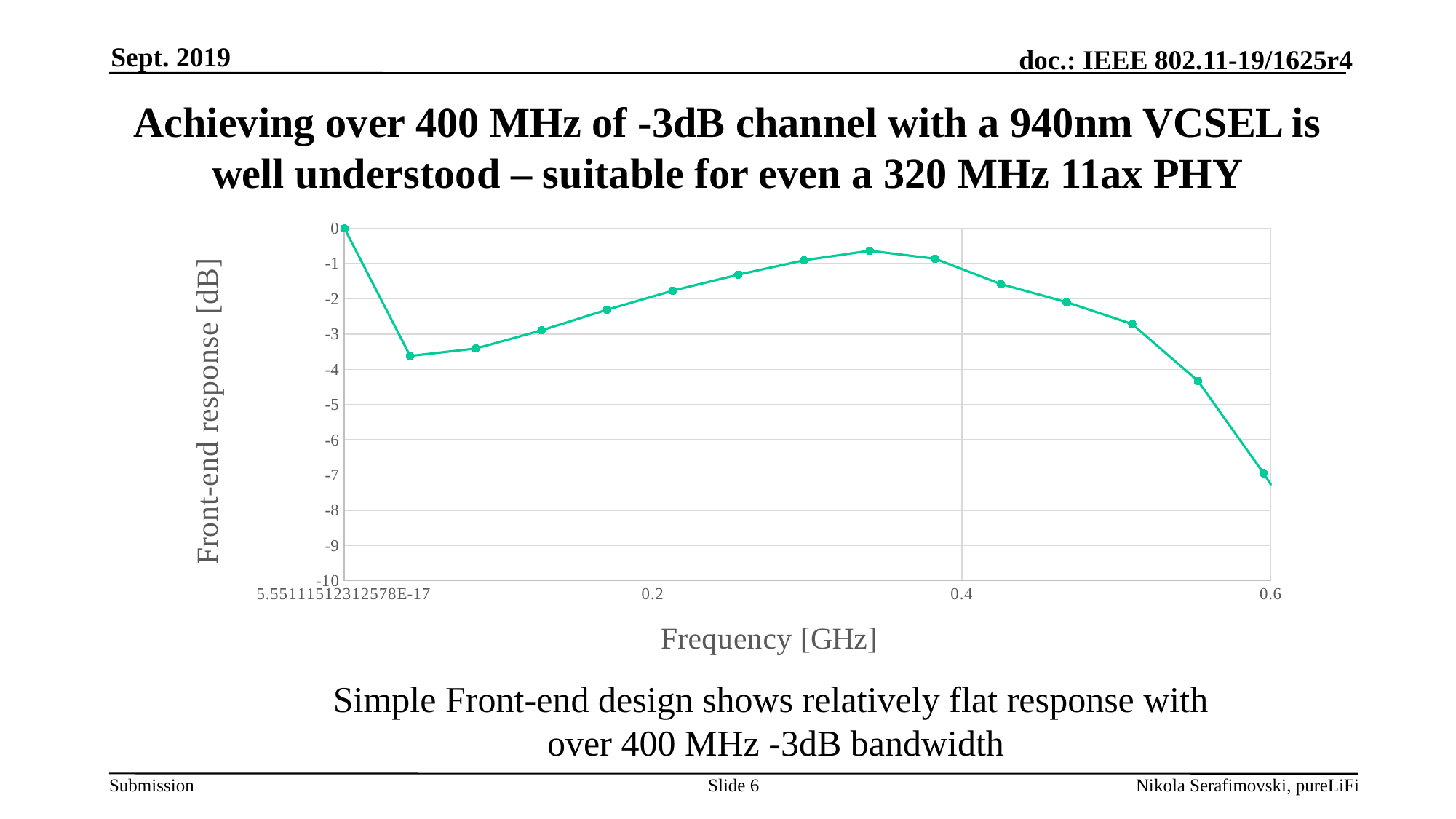
At which frequency on the x axis does the line reach its lowest value? 0.6 How many data points are plotted on the line? 15 Which is larger, the front-end response at 0.2 GHz or at 0.6 GHz? 0.2 GHz Is the front-end response at 0.2 GHz greater or less than -3? greater What is the front-end response value of the first data point on the line? 0 Do the values rise or fall along the x axis between 0.4 GHz and 0.6 GHz? fall What kind of chart is shown on the slide? line chart What is the lowest value shown on the vertical axis? -10 What is the title of the vertical axis of the chart? Front-end response [dB] What is the title of the horizontal axis of the chart? Frequency [GHz] Is the front-end response at 0.6 GHz greater or less than -5? less Is the front-end response at 0.4 GHz greater or less than -2? greater